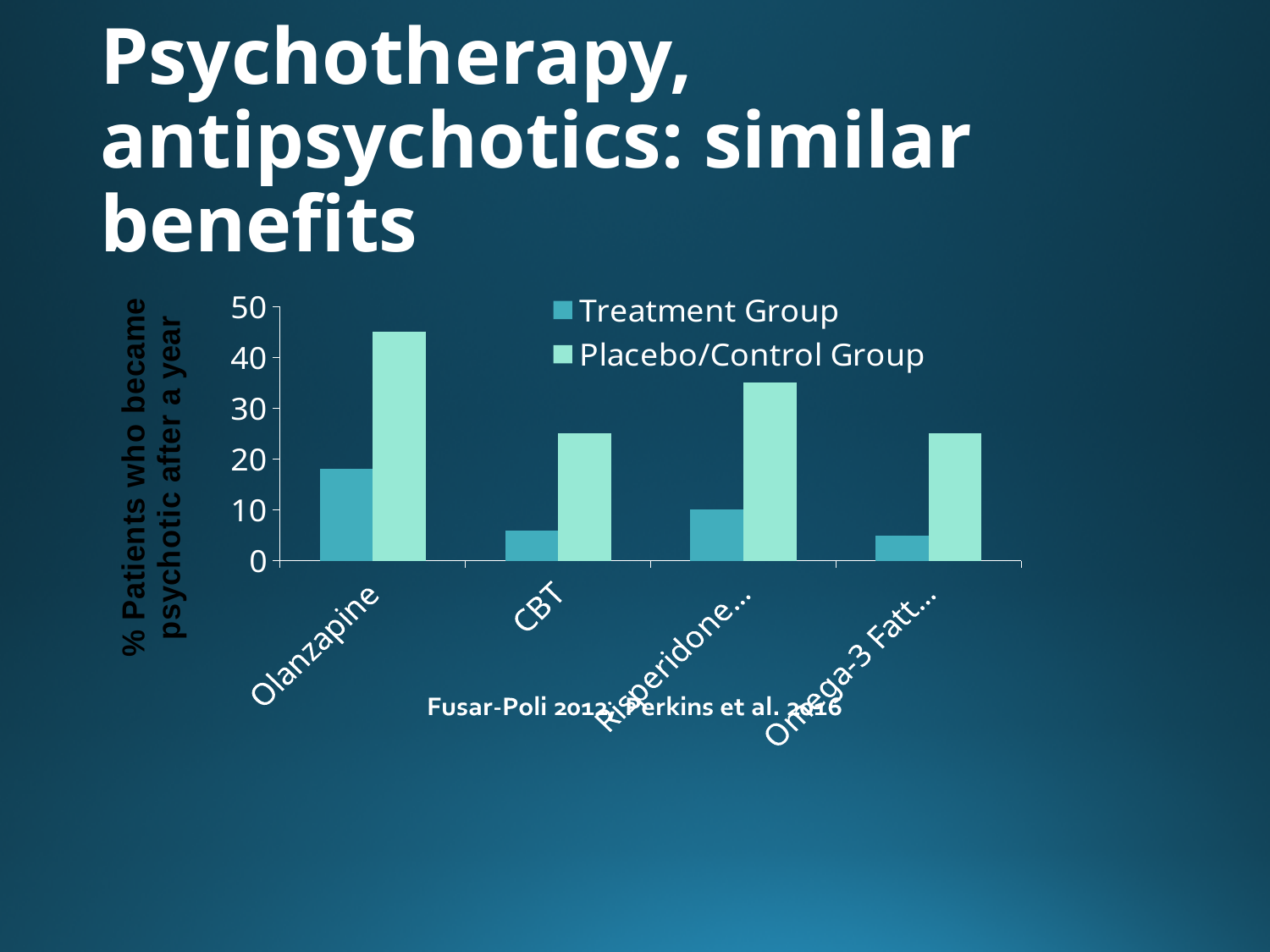
For Olanzapine, which is larger: the Treatment Group value or the Placebo/Control Group value? Placebo/Control Group Which category has the highest Placebo/Control Group value? Olanzapine Is the Placebo/Control Group value for Risperidone greater or less than 30? greater What kind of chart is shown on the slide? bar chart Is the Treatment Group value for Olanzapine greater or less than 20? less Is the Treatment Group value for CBT greater or less than 10? less Which category has the highest Treatment Group value? Olanzapine How many series does the legend list? 2 Which is larger: the Placebo/Control Group value for CBT or for Olanzapine? Olanzapine How many categories are shown on the x axis? 4 What are the two series named in the legend? Treatment Group and Placebo/Control Group